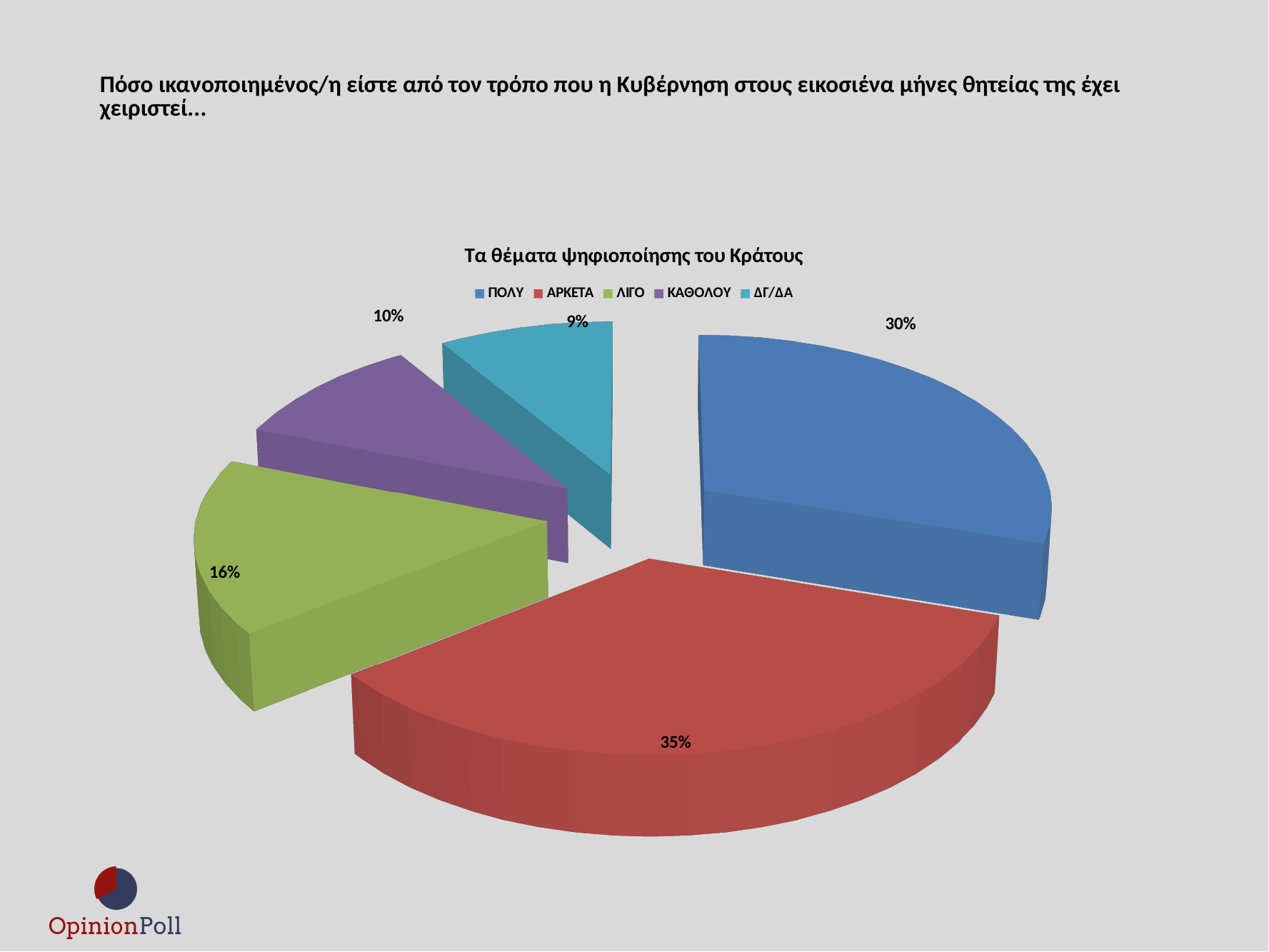
What is the title of the pie chart? Τα θέματα ψηφιοποίησης του Κράτους What is the value for ΠΟΛΥ? 30% Which category has the smallest share of the pie? ΔΓ/ΔΑ What is the value for ΛΙΓΟ? 16% What is the value for ΔΓ/ΔΑ? 9% What is the difference between the values for ΑΡΚΕΤΑ and ΠΟΛΥ? 5% What type of chart is shown on the slide? pie chart Which category has the largest share of the pie? ΑΡΚΕΤΑ Which is larger, the value for ΛΙΓΟ or the value for ΚΑΘΟΛΟΥ? ΛΙΓΟ How many slices does the pie chart have? 5 What is the value for ΚΑΘΟΛΟΥ? 10% What is the value for ΑΡΚΕΤΑ? 35%